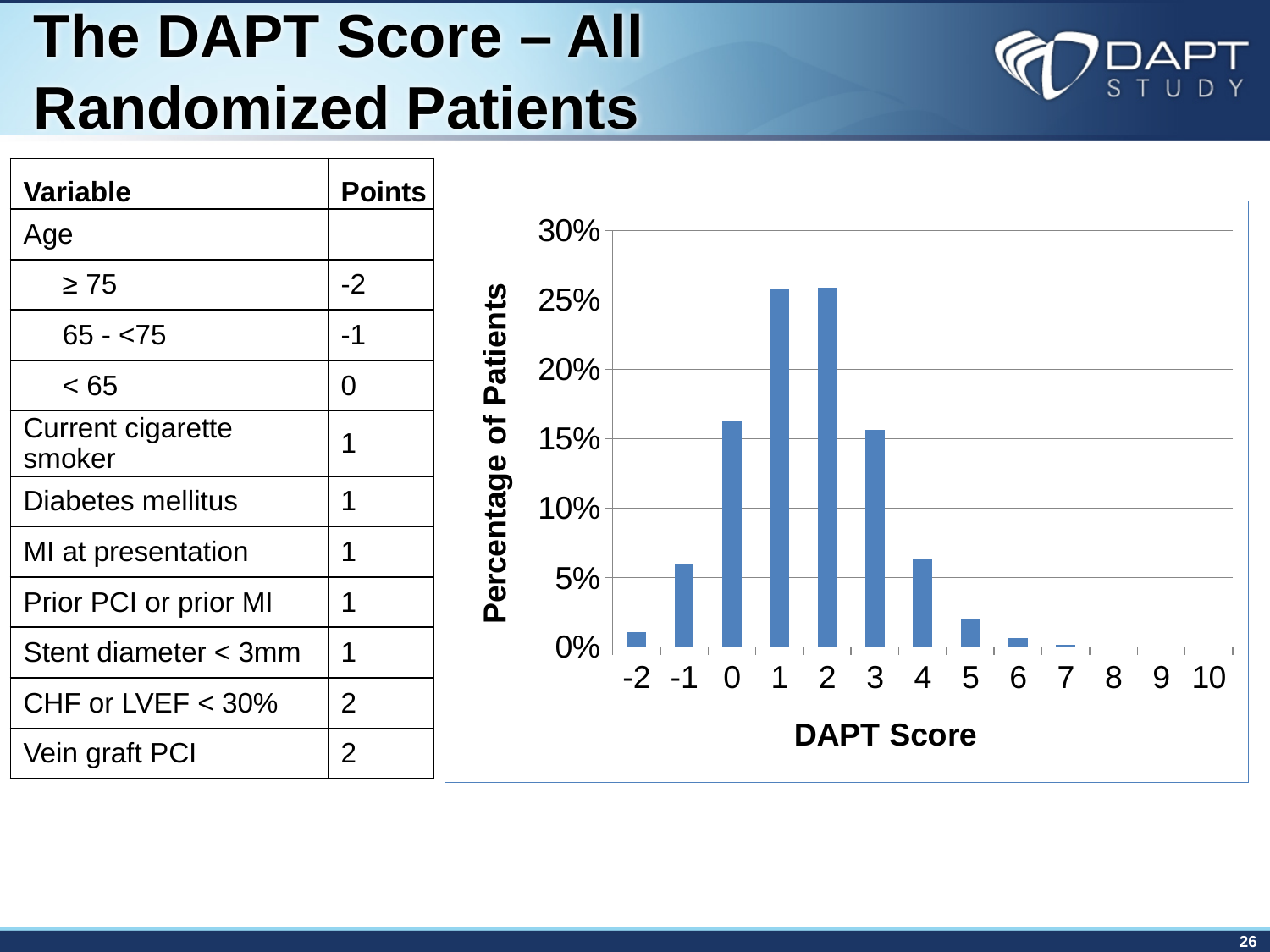
Which has a higher percentage of patients, DAPT Score 0 or DAPT Score -1? DAPT Score 0 What is the title of the y axis of the chart? Percentage of Patients Is the value for DAPT Score -2 greater or less than 5%? less What is the title of the x axis of the chart? DAPT Score Do the values rise or fall as the DAPT Score goes from 2 to 6? fall Is the value for DAPT Score 1 greater or less than 20%? greater Which has a higher percentage of patients, DAPT Score 1 or DAPT Score 3? DAPT Score 1 How many DAPT Score categories are shown on the x axis of the chart? 13 Is the value for DAPT Score 3 greater or less than 10%? greater What kind of chart is shown on the slide? bar chart